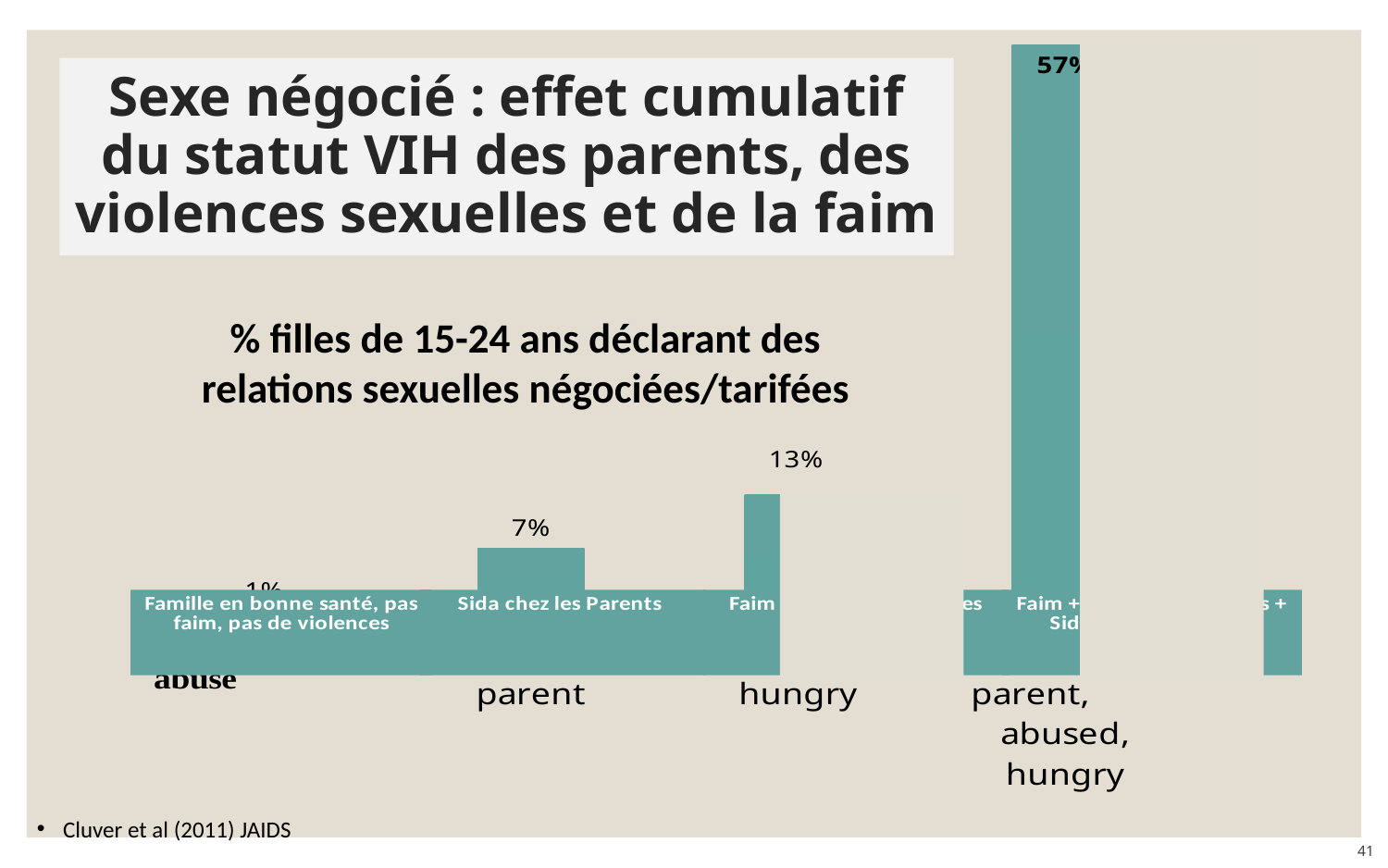
What kind of chart is shown on the slide? Bar chart What percentage is shown for the 'Faim' category? 13% What is the highest value shown on the chart? 57% What percentage is shown for the 'Sida chez les Parents' category? 7% What is the difference between the tallest bar (57%) and the 'Faim' bar? 44% What is the difference between the values for 'Faim' and 'Sida chez les Parents'? 6% Which category has the lowest value on the chart? Famille en bonne santé, pas faim, pas de violences What source is cited at the bottom of the slide? Cluver et al (2011) JAIDS Do the bar values rise or fall from left to right across the chart? Rise What is the title of the chart? % filles de 15-24 ans déclarant des relations sexuelles négociées/tarifées Which has a higher value, 'Faim' or 'Sida chez les Parents'? Faim